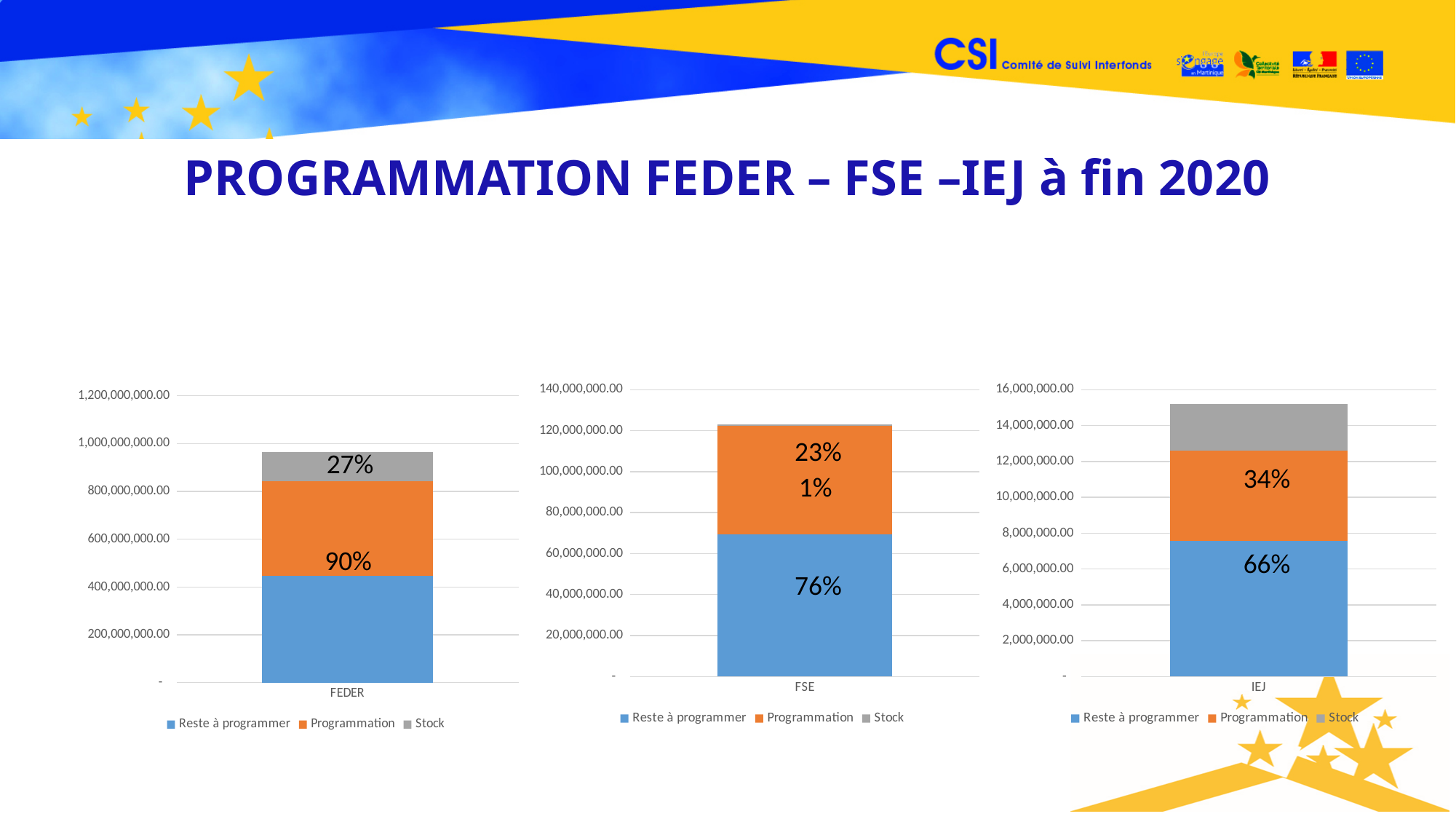
In the IEJ chart, which series has the largest segment? Reste à programmer In the FSE chart, is the Reste à programmer segment greater or less than 60,000,000.00? greater How many series does the legend of the FSE chart list? 3 In the FEDER chart, which is larger, the Programmation segment or the Stock segment? Programmation What kind of chart is the FEDER chart on the left? stacked bar chart How many categories are shown on the x axis of the IEJ chart? 1 In the IEJ chart, which is larger, the Stock segment or the Reste à programmer segment? Reste à programmer In the FSE chart, which series has the smallest segment? Stock In the FEDER chart, is the total height of the stacked bar greater or less than 800,000,000.00? greater Which colour represents the Stock series in the three charts? grey In the FSE chart, is the total height of the stacked bar greater or less than 100,000,000.00? greater